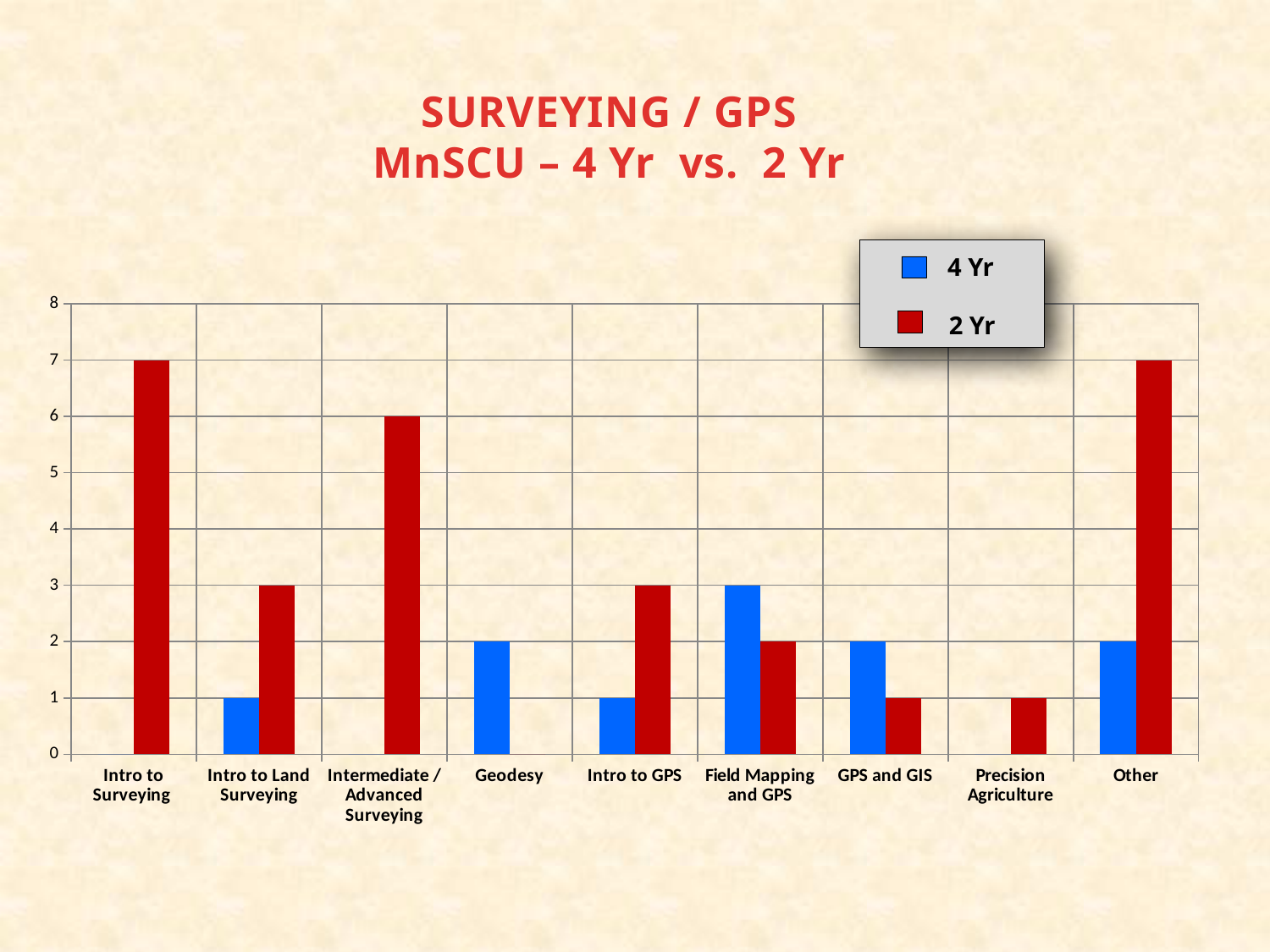
Is the 2 Yr value for Intro to GPS greater or less than 5? less How many series does the legend list? 2 What is the 4 Yr value for Geodesy? 2 What is the 2 Yr value for Intro to Surveying? 7 What is the 4 Yr value for Field Mapping and GPS? 3 What is the 2 Yr value for Intermediate / Advanced Surveying? 6 What is the difference between the 2 Yr and 4 Yr values for Other? 5 How many course categories are shown on the x axis? 9 Which category has the highest 4 Yr value? Field Mapping and GPS For GPS and GIS, which is larger, the 4 Yr value or the 2 Yr value? 4 Yr What kind of chart is shown on the slide? Bar chart Which colour represents the 2 Yr series in the legend? Red